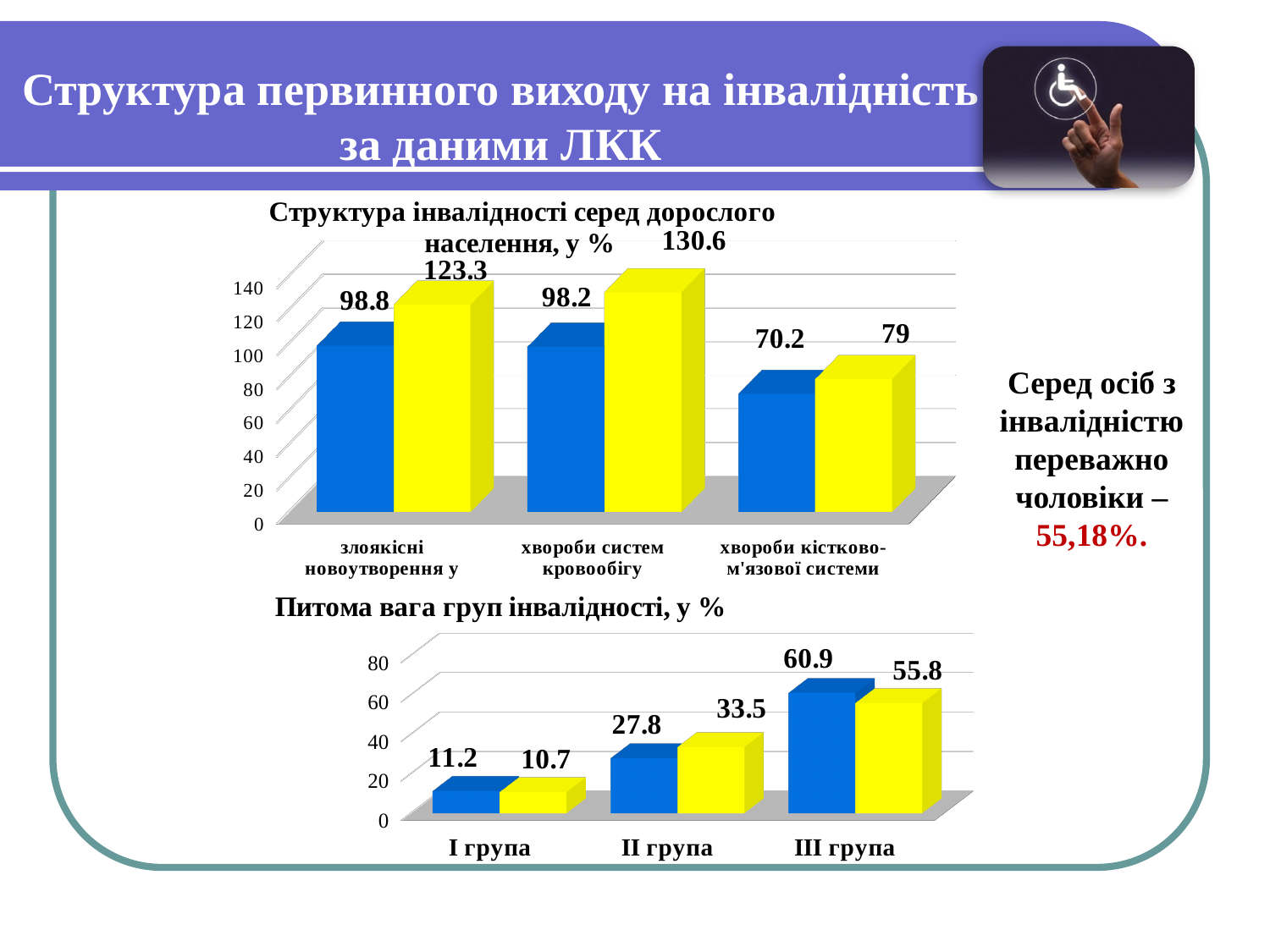
In the bottom chart 'Питома вага груп інвалідності, у %', what is the value of the yellow bar for 'I група'? 10.7 In the bottom chart 'Питома вага груп інвалідності, у %', do the blue bar values rise or fall from 'I група' to 'III група'? rise In the top chart 'Структура інвалідності серед дорослого населення, у %', which is larger: the blue bar for 'злоякісні новоутворення' or the blue bar for 'хвороби кістково-м'язової системи'? злоякісні новоутворення What type of chart is the bottom chart 'Питома вага груп інвалідності, у %'? bar chart In the top chart 'Структура інвалідності серед дорослого населення, у %', what is the value of the yellow bar for 'хвороби систем кровообігу'? 130.6 In the top chart 'Структура інвалідності серед дорослого населення, у %', how many categories are shown on the x axis? 3 In the top chart 'Структура інвалідності серед дорослого населення, у %', which category has the lowest yellow bar? хвороби кістково-м'язової системи In the bottom chart 'Питома вага груп інвалідності, у %', what is the value of the blue bar for 'III група'? 60.9 In the bottom chart 'Питома вага груп інвалідності, у %', which group has the highest blue bar? III група In the bottom chart 'Питома вага груп інвалідності, у %', what is the difference between the yellow and blue bars for 'II група'? 5.7 In the top chart 'Структура інвалідності серед дорослого населення, у %', what is the difference between the yellow and blue bars for 'хвороби кістково-м'язової системи'? 8.8 In the top chart 'Структура інвалідності серед дорослого населення, у %', what is the value of the blue bar for 'злоякісні новоутворення'? 98.8